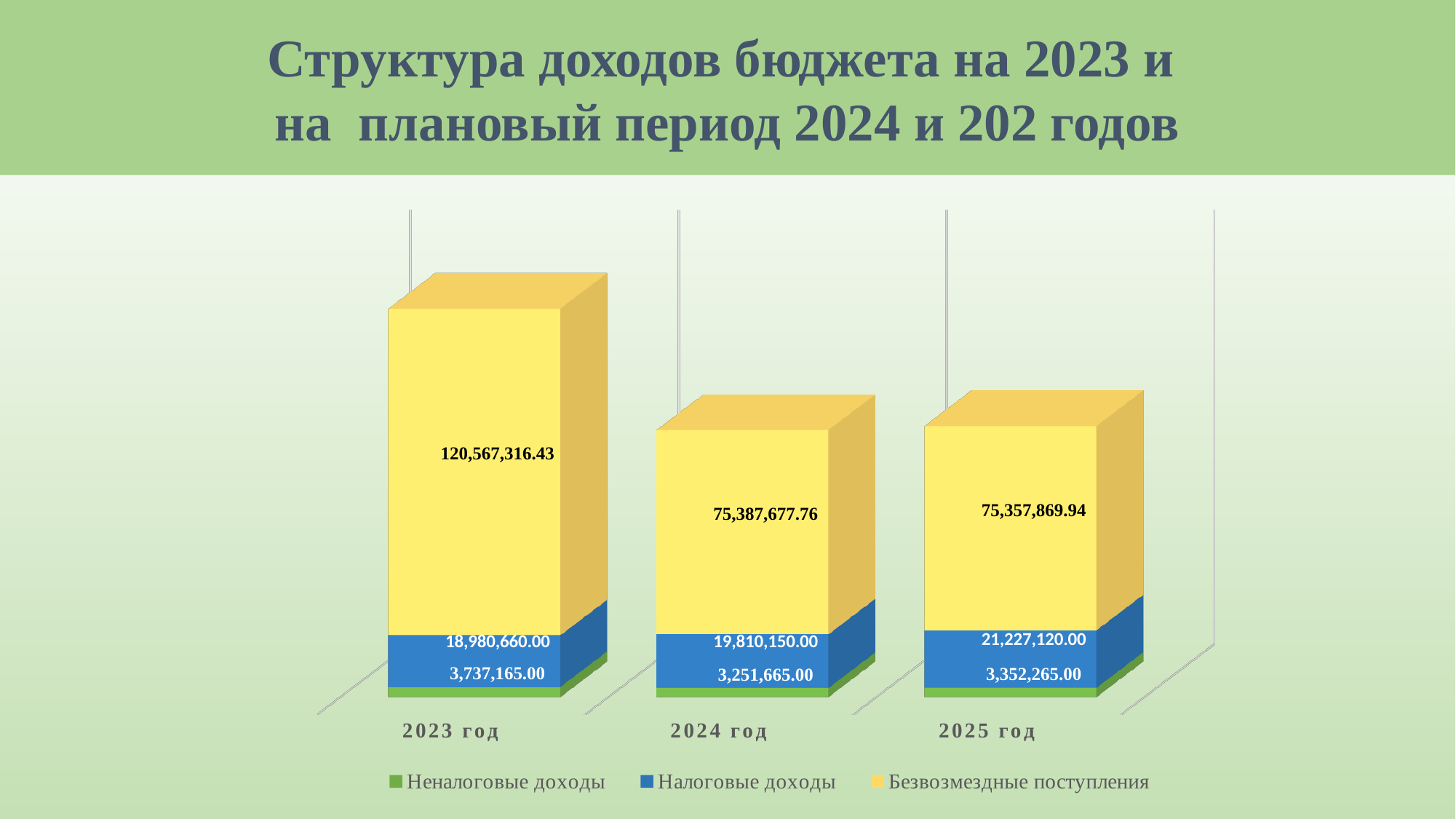
What type of chart is shown on the slide? Stacked bar chart Which is larger: Налоговые доходы in 2024 год or in 2025 год? 2025 год What is the value of Налоговые доходы for 2025 год? 21,227,120.00 How many year categories are shown on the x axis? 3 What is the total of the stacked bar for 2024 год? 98,449,492.76 In which year is Безвозмездные поступления the highest? 2023 год How many series does the legend list? 3 What is the value of Неналоговые доходы for 2024 год? 3,251,665.00 Does Налоговые доходы rise or fall from 2023 год to 2025 год? Rises What is the difference between Налоговые доходы in 2025 год and in 2023 год? 2,246,460.00 In which year is Неналоговые доходы the lowest? 2024 год What is the value of Безвозмездные поступления for 2023 год? 120,567,316.43